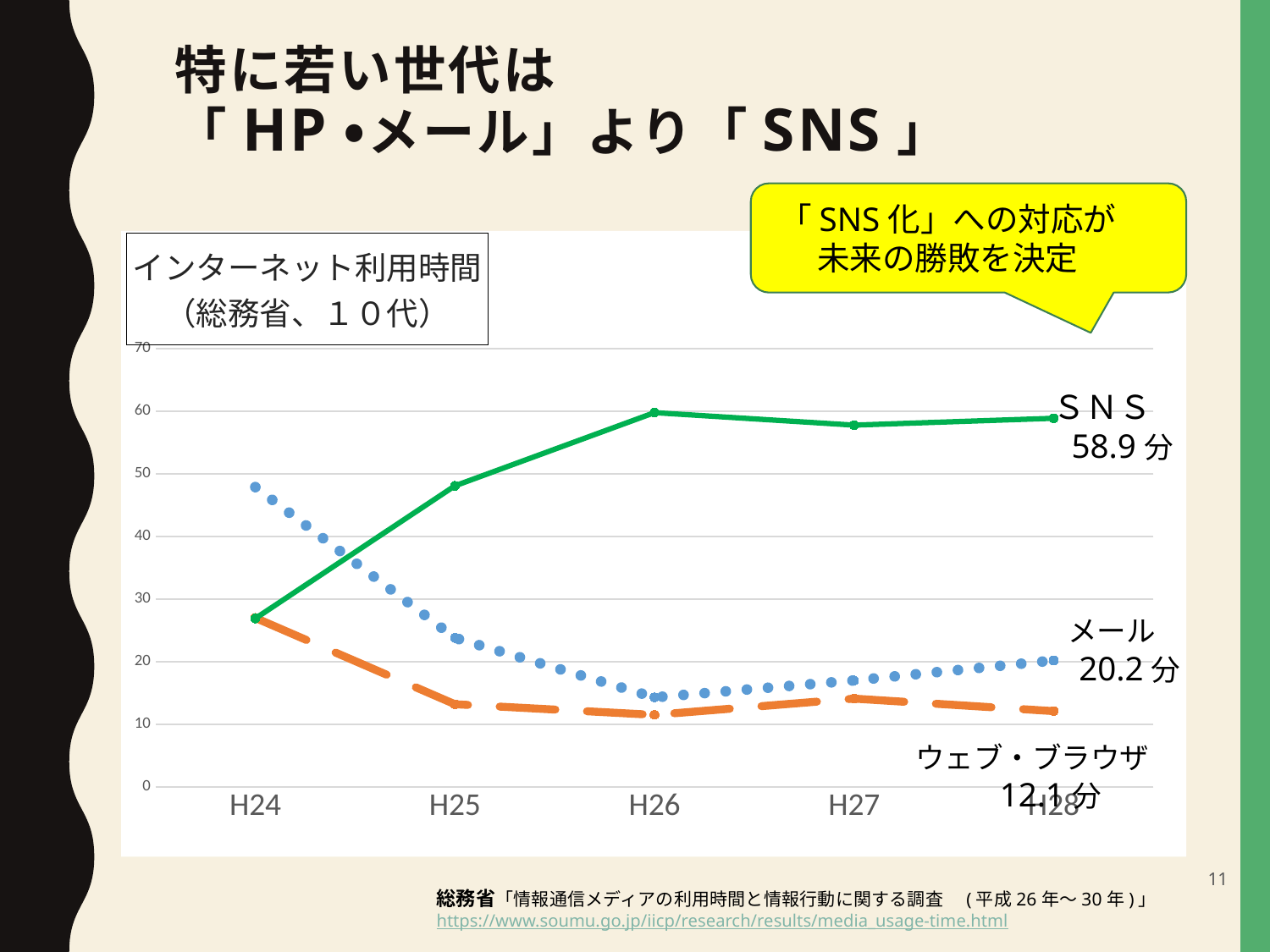
Is the value for SNS at H26 greater or less than 50? greater Which series has the lowest value at H28? ウェブ・ブラウザ How many time points (years) are plotted along the x axis? 5 What is the value for SNS at H28? 58.9分 Does the SNS line rise or fall from H24 to H28? rise How many series are plotted in the chart? 3 What is the value for メール at H28? 20.2分 What is the difference between SNS and メール at H28? 38.7分 Which series has the highest value at H28? SNS At H24, which is larger: メール or SNS? メール What is the value for ウェブ・ブラウザ at H28? 12.1分 What kind of chart is shown on the slide? line chart